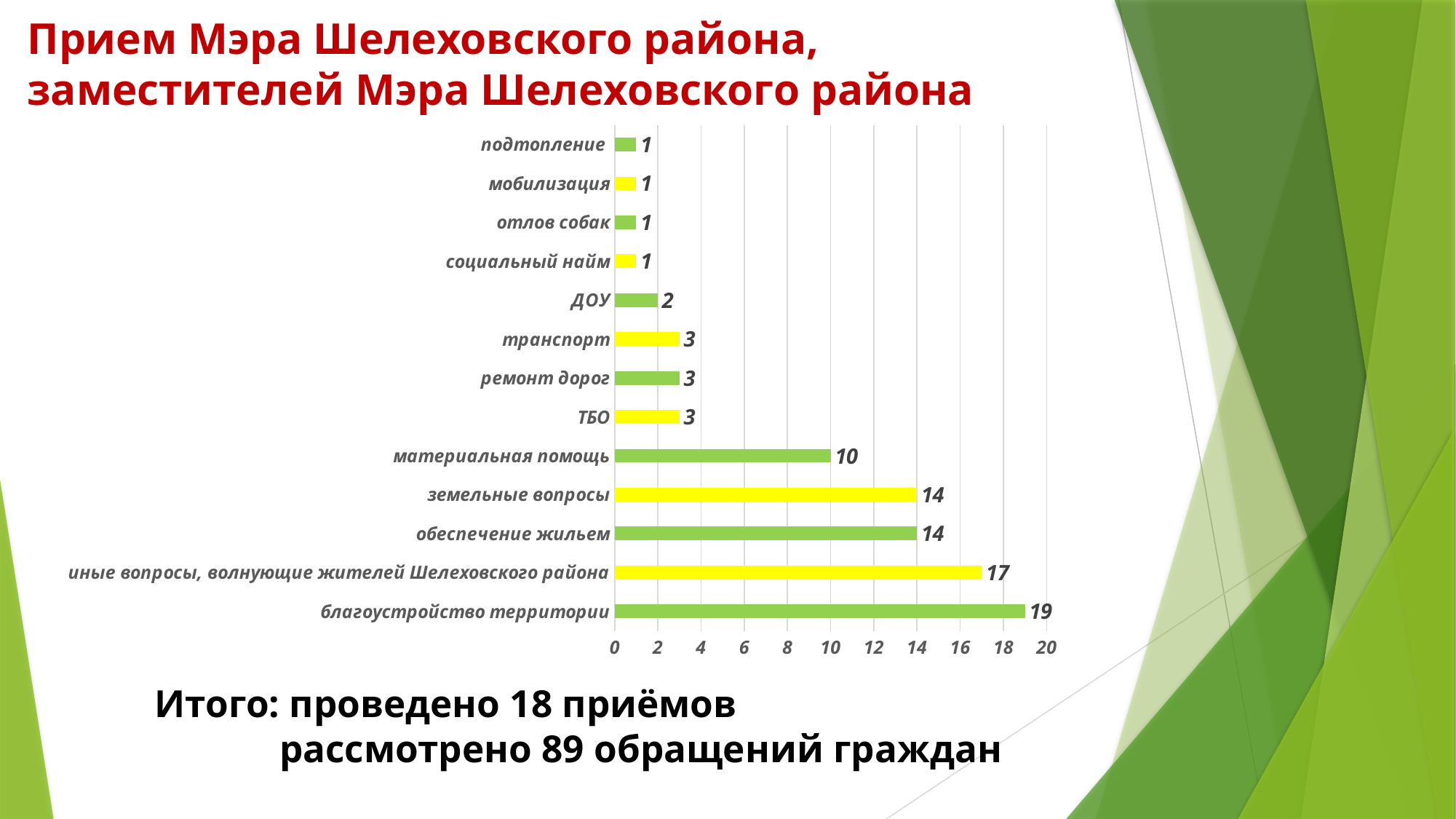
Is the value for иные вопросы, волнующие жителей Шелеховского района greater or less than 10? greater What kind of chart is shown on the slide? bar chart What is the maximum value shown on the horizontal axis? 20 What is the difference between земельные вопросы and материальная помощь? 4 What is the difference between благоустройство территории and обеспечение жильем? 5 Which category has the highest value? благоустройство территории How many categories are shown in the chart? 13 What is the value for иные вопросы, волнующие жителей Шелеховского района? 17 Which is larger, транспорт or материальная помощь? материальная помощь What is the value for благоустройство территории? 19 What is the value for материальная помощь? 10 What is the value for ДОУ? 2